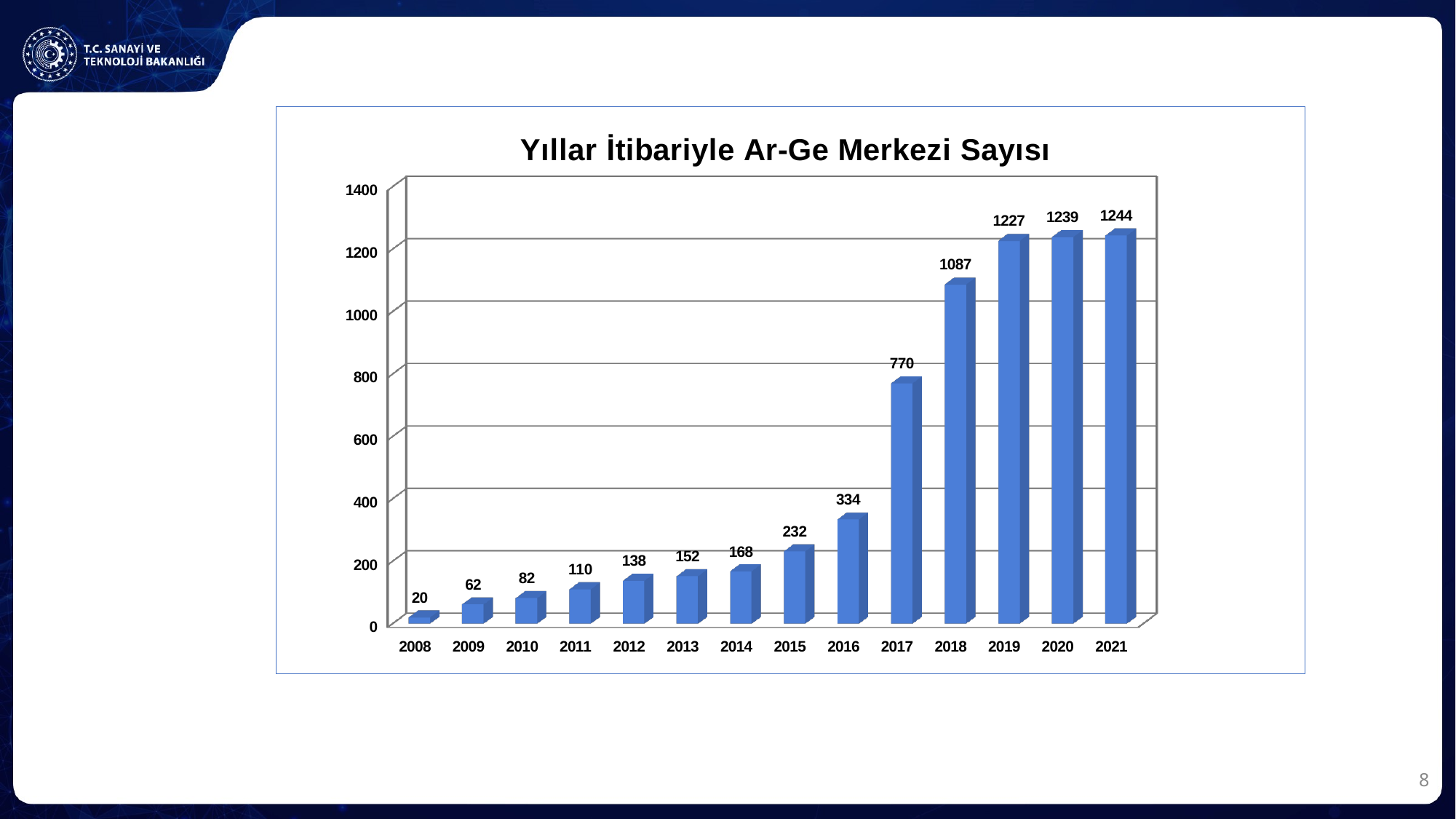
What is the value for 2017? 770 Which is larger, the value for 2013 or the value for 2014? 2014 What is the difference between the values for 2016 and 2015? 102 Which year has the lowest value? 2008 Is the value for 2019 greater or less than 1200? greater How many years are shown on the x axis? 14 What is the value for 2021? 1244 What is the value for 2012? 138 What kind of chart is shown on the slide? Bar chart Do the values rise or fall from 2008 to 2021? Rise Which year has the highest value? 2021 What is the difference between the values for 2018 and 2017? 317